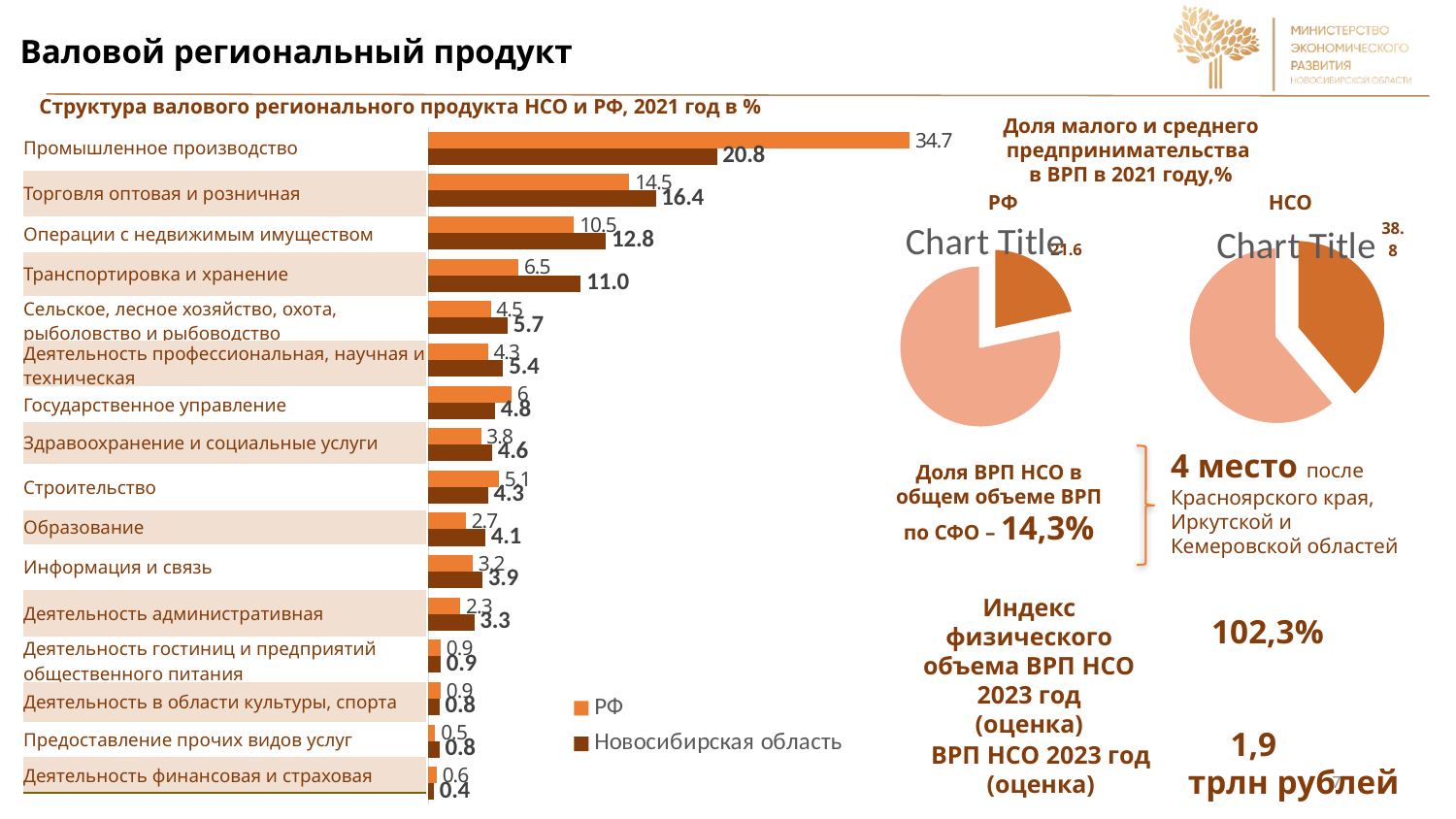
In the bar chart 'Структура валового регионального продукта НСО и РФ, 2021 год в %', which category has the lowest value for Новосибирская область? Деятельность финансовая и страховая How many categories are shown in the bar chart 'Структура валового регионального продукта НСО и РФ, 2021 год в %'? 16 In the bar chart 'Структура валового регионального продукта НСО и РФ, 2021 год в %', which is larger for Торговля оптовая и розничная: the РФ value or the Новосибирская область value? Новосибирская область In the bar chart 'Структура валового регионального продукта НСО и РФ, 2021 год в %', what is the value for Промышленное производство for the РФ series? 34.7 In the pie chart for РФ under 'Доля малого и среднего предпринимательства в ВРП в 2021 году,%', what value is labelled on the highlighted slice? 21.6 In the bar chart 'Структура валового регионального продукта НСО и РФ, 2021 год в %', what is the difference between the РФ and Новосибирская область values for Промышленное производство? 13.9 In the bar chart 'Структура валового регионального продукта НСО и РФ, 2021 год в %', which category has the highest value for Новосибирская область? Промышленное производство In the bar chart 'Структура валового регионального продукта НСО и РФ, 2021 год в %', what is the value for Транспортировка и хранение for Новосибирская область? 11.0 How many series does the legend of the bar chart 'Структура валового регионального продукта НСО и РФ, 2021 год в %' list? 2 In the bar chart 'Структура валового регионального продукта НСО и РФ, 2021 год в %', which series is shown in dark brown according to the legend? Новосибирская область What kind of chart is 'Структура валового регионального продукта НСО и РФ, 2021 год в %'? Bar chart In the pie chart for НСО under 'Доля малого и среднего предпринимательства в ВРП в 2021 году,%', what value is labelled on the highlighted slice? 38.8